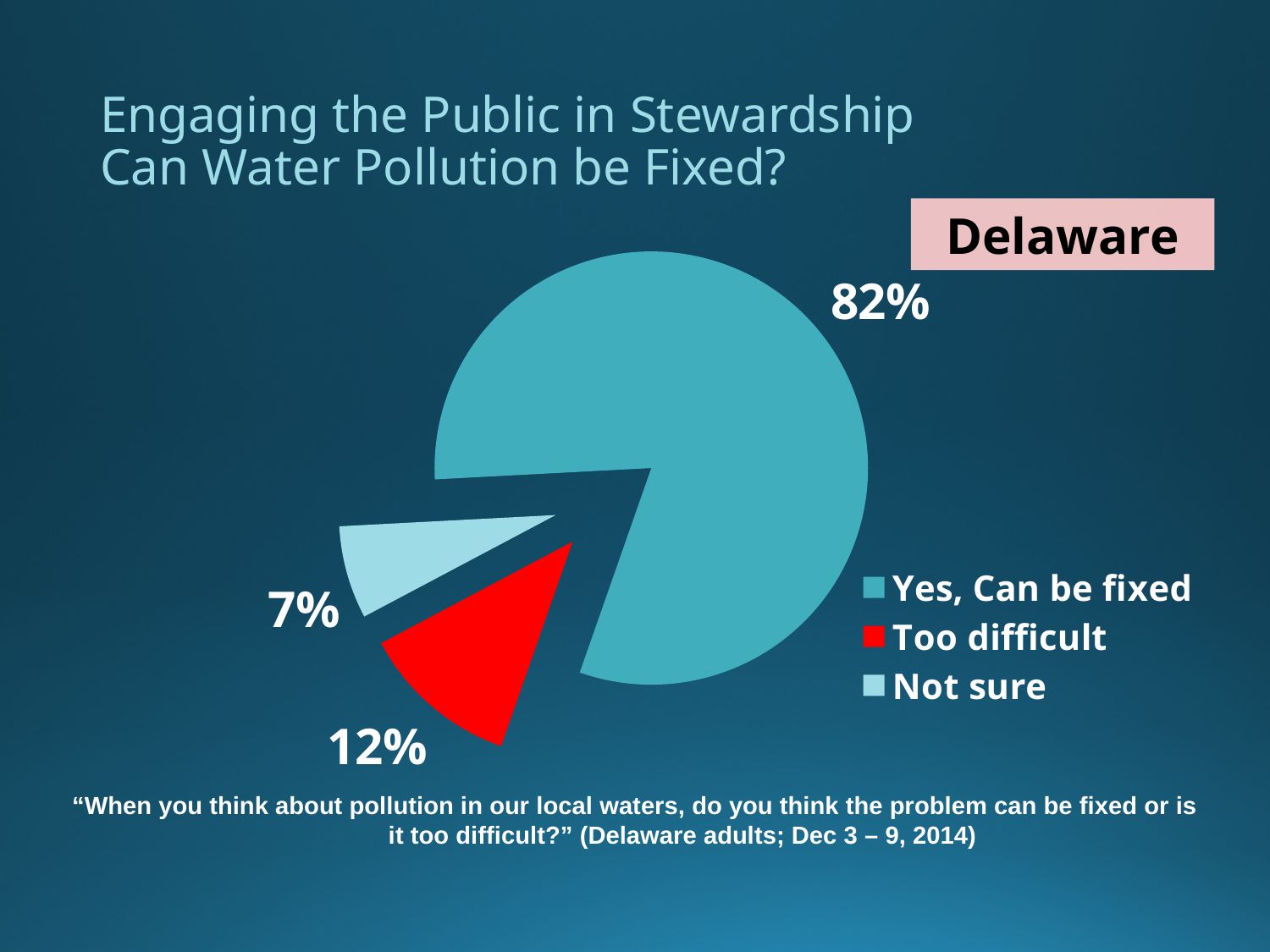
Which state is named in the label box above the chart? Delaware What kind of chart is shown on the slide? pie chart Which is larger, the share for 'Too difficult' or the share for 'Not sure'? Too difficult Which response has the largest share of the pie? Yes, Can be fixed What is the difference in percentage points between 'Yes, Can be fixed' and 'Too difficult'? 70 What is the difference in percentage points between 'Too difficult' and 'Not sure'? 5 Which response has the smallest share of the pie? Not sure How many categories does the legend list? 3 What percentage of respondents said 'Too difficult'? 12% Which colour represents 'Too difficult' in the pie chart? red What percentage of respondents said 'Yes, Can be fixed'? 82% What percentage of respondents said 'Not sure'? 7%